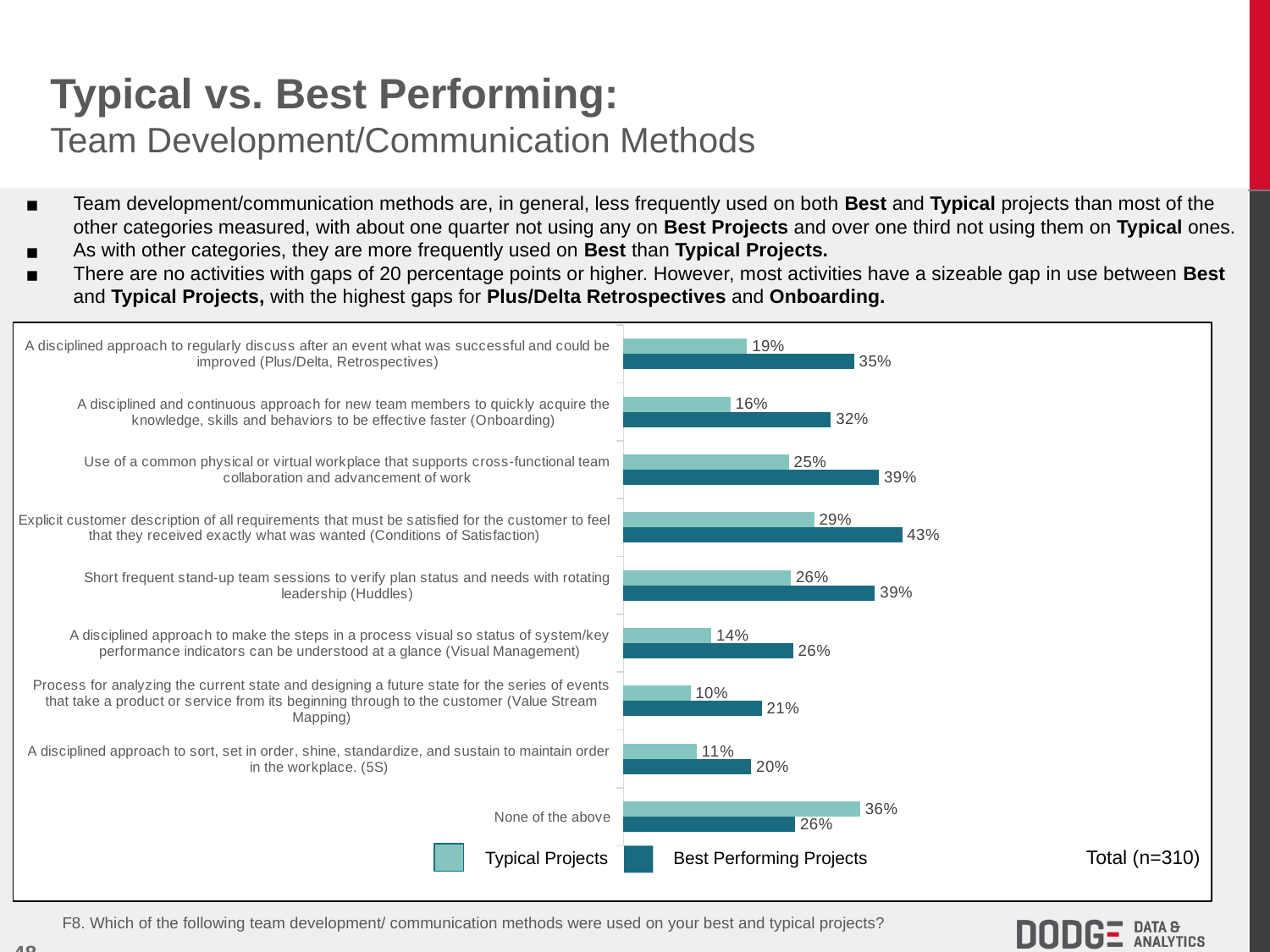
Which category has the highest Best Performing Projects value? Conditions of Satisfaction What is the Typical Projects value for Value Stream Mapping? 10% What is the difference between the Best Performing Projects and Typical Projects values for Plus/Delta, Retrospectives? 16 percentage points How many categories are shown in the chart? 9 What kind of chart is shown on the slide? Bar chart What is the Typical Projects value for Onboarding? 16% What is the total sample size shown next to the legend? Total (n=310) What is the Best Performing Projects value for Conditions of Satisfaction? 43% How many series does the legend list? 2 What is the Best Performing Projects value for 5S? 20% For None of the above, which is larger: the Typical Projects value or the Best Performing Projects value? Typical Projects Which category has the lowest Typical Projects value? Value Stream Mapping